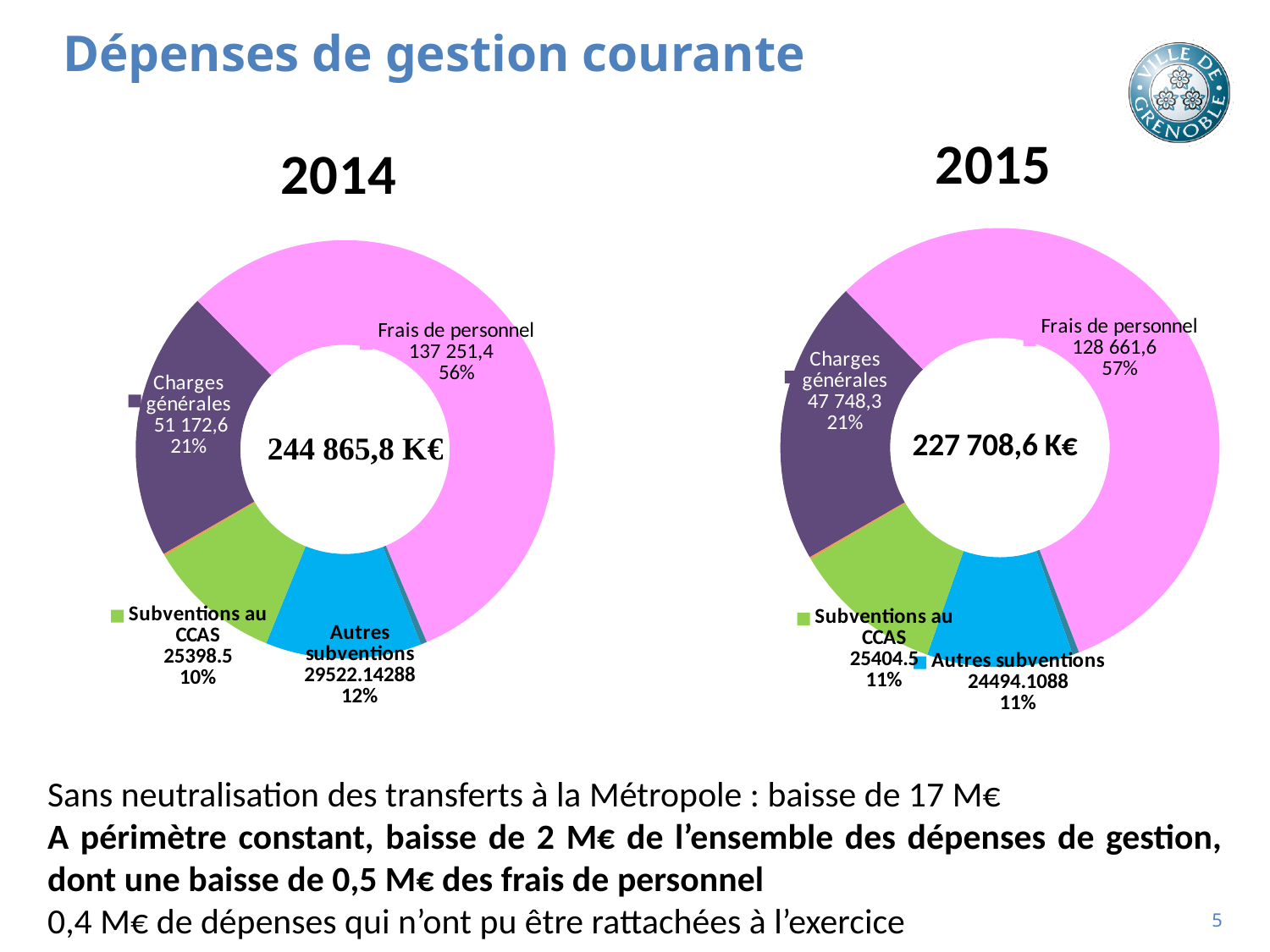
In the 2014 chart, which category is the largest? Frais de personnel What total is printed in the centre of the 2015 chart? 227 708,6 K€ Which is larger: Charges générales in the 2014 chart or in the 2015 chart? 2014 In the 2014 chart, what share does Subventions au CCAS represent? 10% In the 2015 chart, what share does Frais de personnel represent? 57% In the 2014 chart, what is the value for Autres subventions? 29522.14288 In the 2014 chart, what is the value for Frais de personnel? 137 251,4 What is the difference between Frais de personnel in the 2014 chart and in the 2015 chart? 8 589,8 In the 2015 chart, what is the value for Charges générales? 47 748,3 In the 2015 chart, what is the value for Subventions au CCAS? 25404.5 How many categories does the 2015 chart show? 6